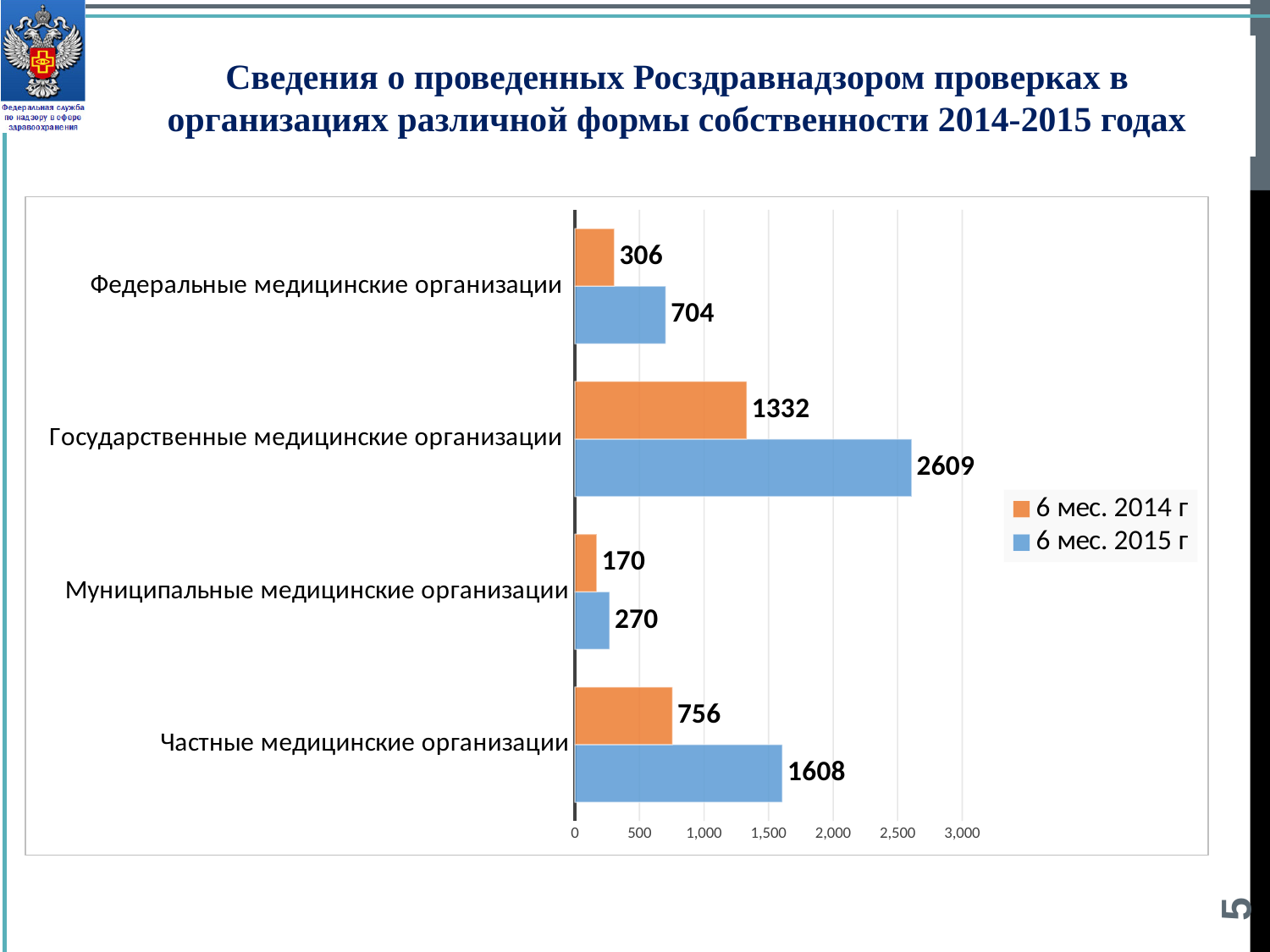
Which category has the lowest value in the 6 мес. 2015 г series? Муниципальные медицинские организации Which is larger: the 6 мес. 2015 г value for Федеральные медицинские организации or the 6 мес. 2014 г value for Частные медицинские организации? 6 мес. 2014 г value for Частные медицинские организации What is the value for Частные медицинские организации in the 6 мес. 2015 г series? 1608 What is the value for Федеральные медицинские организации in the 6 мес. 2014 г series? 306 What is the difference between the 6 мес. 2015 г and 6 мес. 2014 г values for Частные медицинские организации? 852 Which category has the highest value in the 6 мес. 2014 г series? Государственные медицинские организации What is the value for Государственные медицинские организации in the 6 мес. 2015 г series? 2609 How many categories are shown on the chart? 4 What kind of chart is shown on the slide? bar chart Is the 6 мес. 2015 г value for Государственные медицинские организации greater or less than 2,500? greater Which colour represents the 6 мес. 2015 г series? blue How many series does the legend list? 2